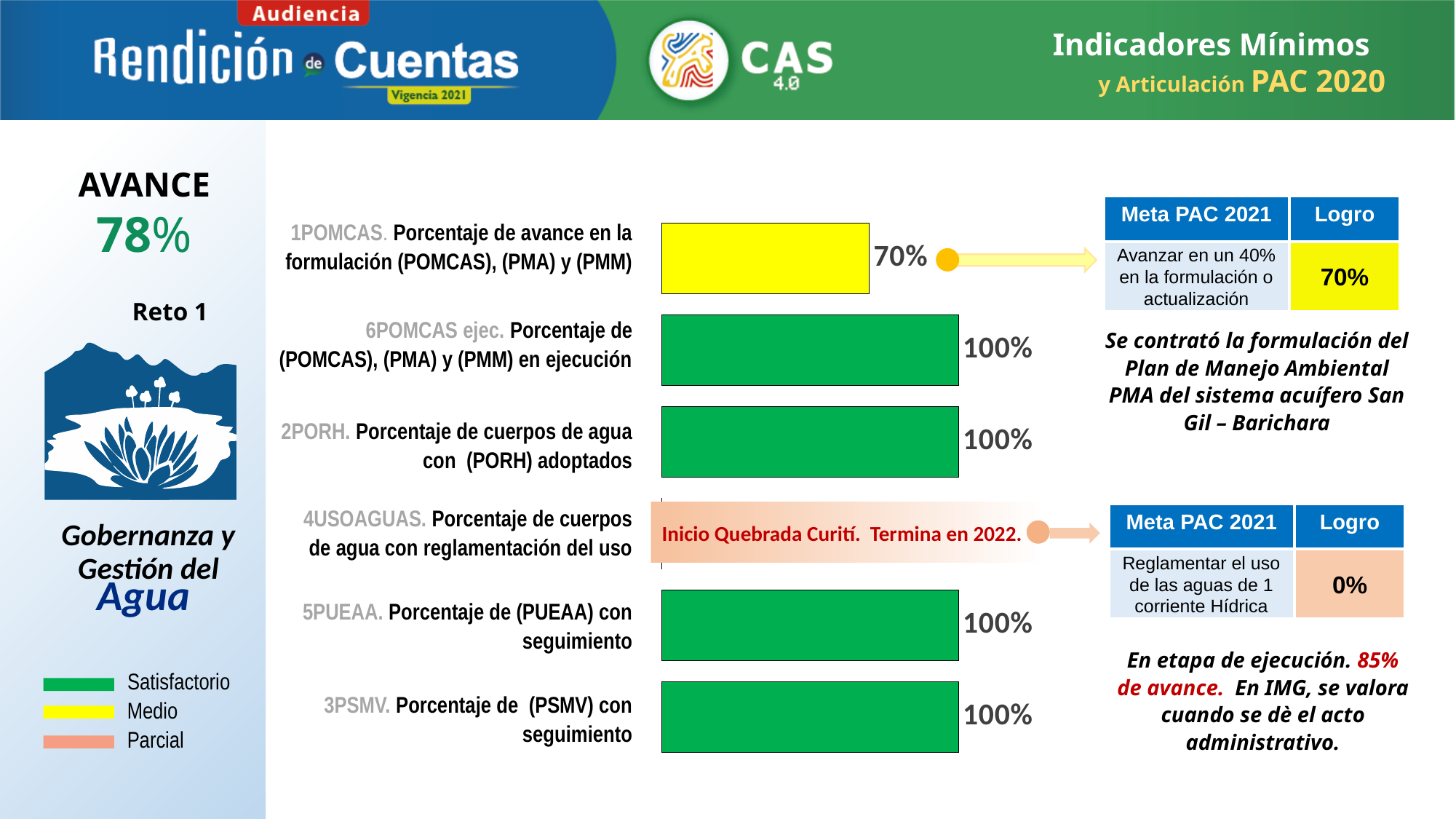
What is the value shown for the 5PUEAA indicator (Porcentaje de (PUEAA) con seguimiento)? 100% What is the value shown for the 3PSMV indicator (Porcentaje de (PSMV) con seguimiento)? 100% Which indicator has the lowest value among those with a bar shown? 1POMCAS Which is larger, the value for 1POMCAS or the value for 2PORH? 2PORH What is the value shown for the 6POMCAS ejec. indicator? 100% According to the legend, what does the green colour represent? Satisfactorio What is the value shown for the 1POMCAS indicator (Porcentaje de avance en la formulación (POMCAS), (PMA) y (PMM))? 70% What kind of chart is used to show the indicator values? Bar chart How many indicators are listed in the chart? 6 What is the difference between the value for 6POMCAS ejec. and the value for 1POMCAS? 30% What colour is the bar for the 1POMCAS indicator? Yellow What is the value shown for the 2PORH indicator (Porcentaje de cuerpos de agua con (PORH) adoptados)? 100%